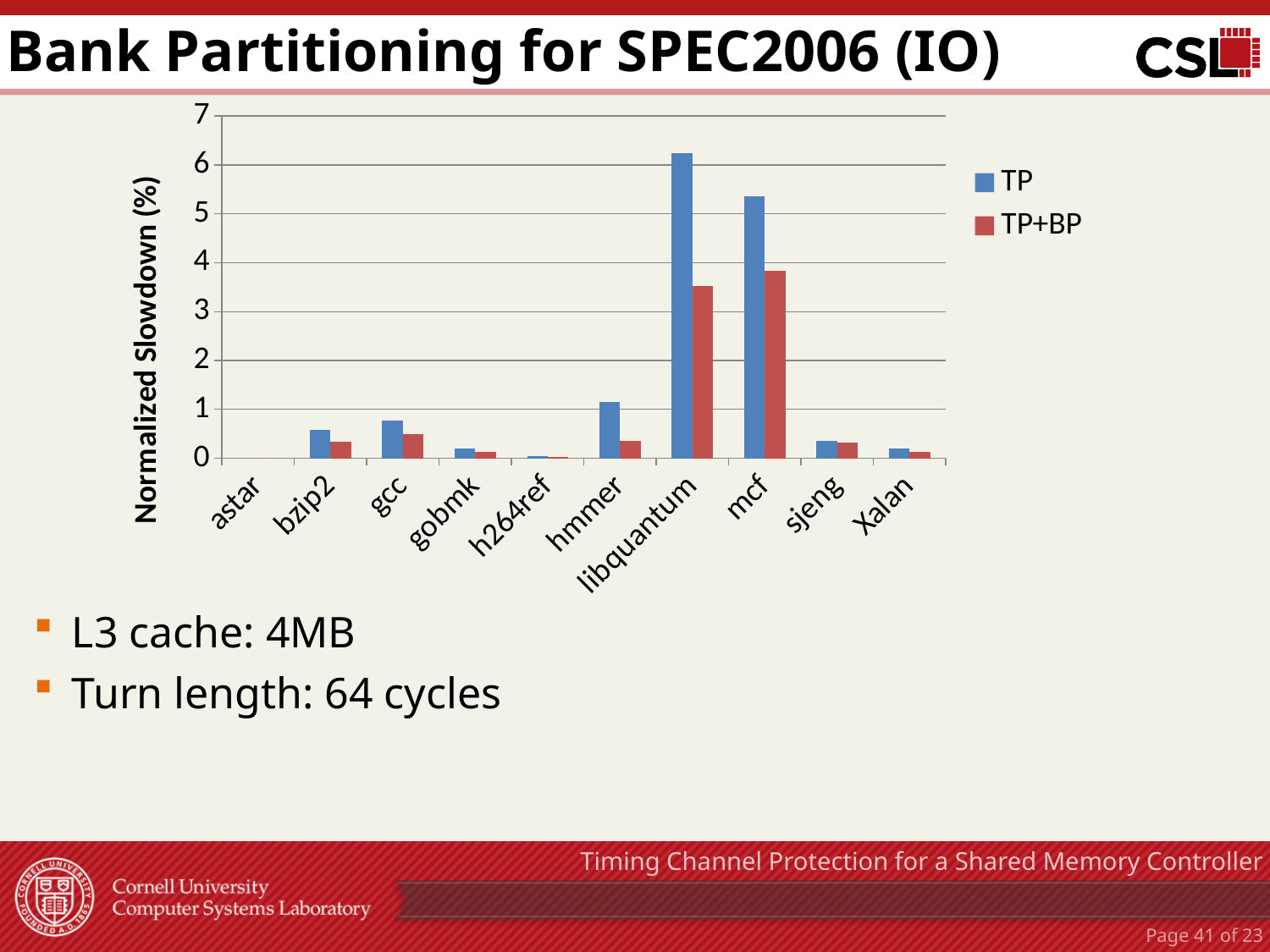
How many benchmark categories are shown on the x axis? 10 Is the TP value for libquantum greater or less than 5? greater Is the TP value for mcf greater or less than 4? greater What kind of chart is shown on the slide? bar chart For libquantum, which is larger: the TP value or the TP+BP value? TP How many series does the legend list? 2 Is the TP value for gcc greater or less than 1? less Which benchmark has the highest TP+BP value? mcf What is the label on the y axis of the chart? Normalized Slowdown (%) Which benchmark has the highest TP value? libquantum Which is larger: the TP value for libquantum or the TP value for mcf? libquantum